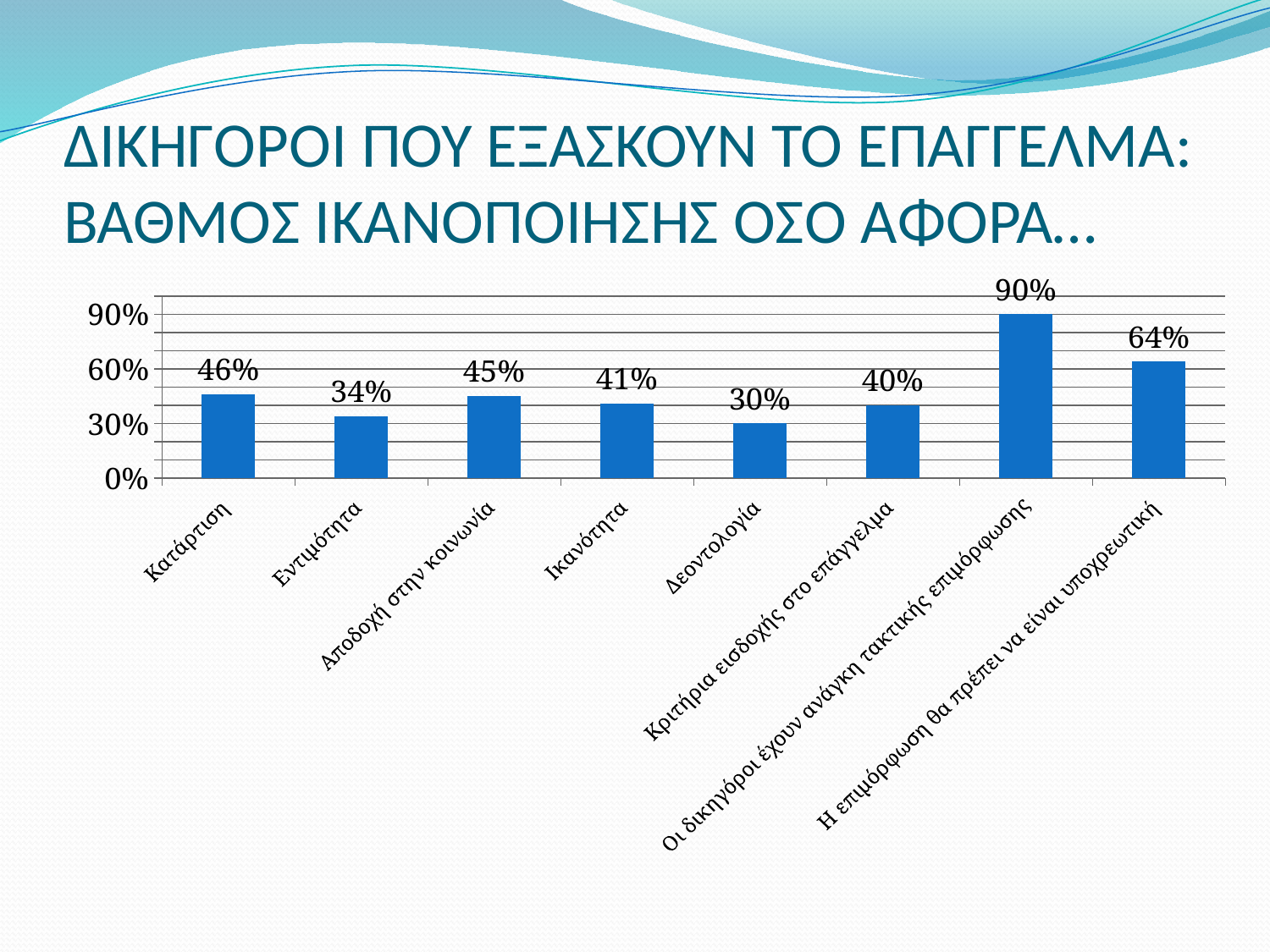
Which is larger, the value for Ικανότητα or the value for Κριτήρια εισδοχής στο επάγγελμα? Ικανότητα What is the value for Κατάρτιση? 46% What kind of chart is shown on the slide? bar chart What is the difference between the values for Οι δικηγόροι έχουν ανάγκη τακτικής επιμόρφωσης and Η επιμόρφωση θα πρέπει να είναι υποχρεωτική? 26% Which category has the lowest value? Δεοντολογία What is the value for Δεοντολογία? 30% What is the value for Η επιμόρφωση θα πρέπει να είναι υποχρεωτική? 64% What is the difference between the values for Κατάρτιση and Εντιμότητα? 12% What is the value for Εντιμότητα? 34% How many categories are shown on the chart? 8 Which category has the highest value? Οι δικηγόροι έχουν ανάγκη τακτικής επιμόρφωσης Is the value for Αποδοχή στην κοινωνία greater or less than 30%? greater